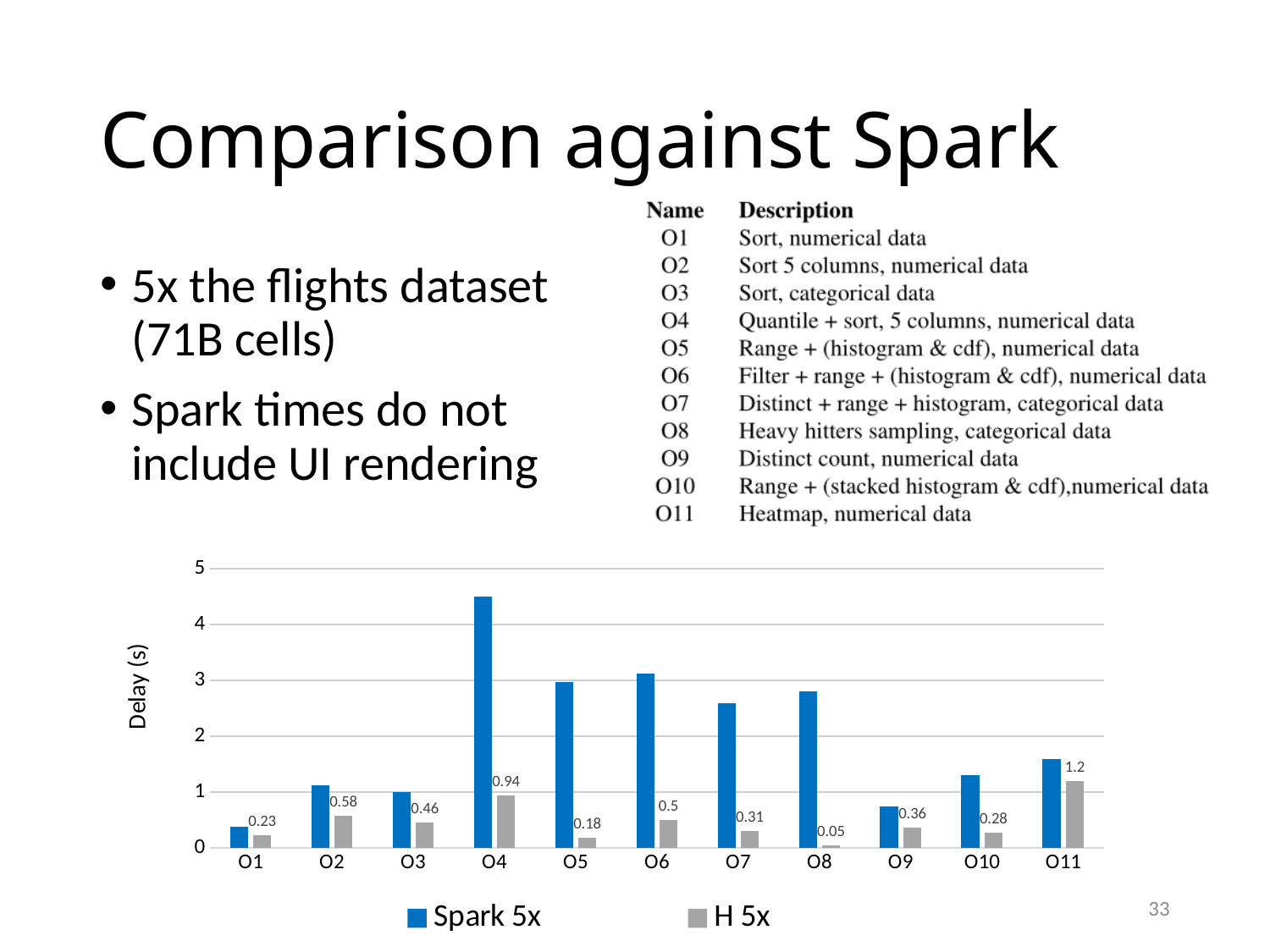
What is the H 5x value for O11? 1.2 How many series does the legend list? 2 Which is larger, the H 5x value for O2 or for O3? O2 What is the H 5x value for O8? 0.05 Which category has the lowest H 5x value? O8 What is the H 5x value for O4? 0.94 Is the Spark 5x value for O8 greater or less than 2? greater How many categories are shown on the x axis? 11 What is the label of the y axis? Delay (s) Is the Spark 5x value for O4 greater or less than 4? greater What is the difference between the H 5x values for O4 and O5? 0.76 Which category has the highest H 5x value? O11